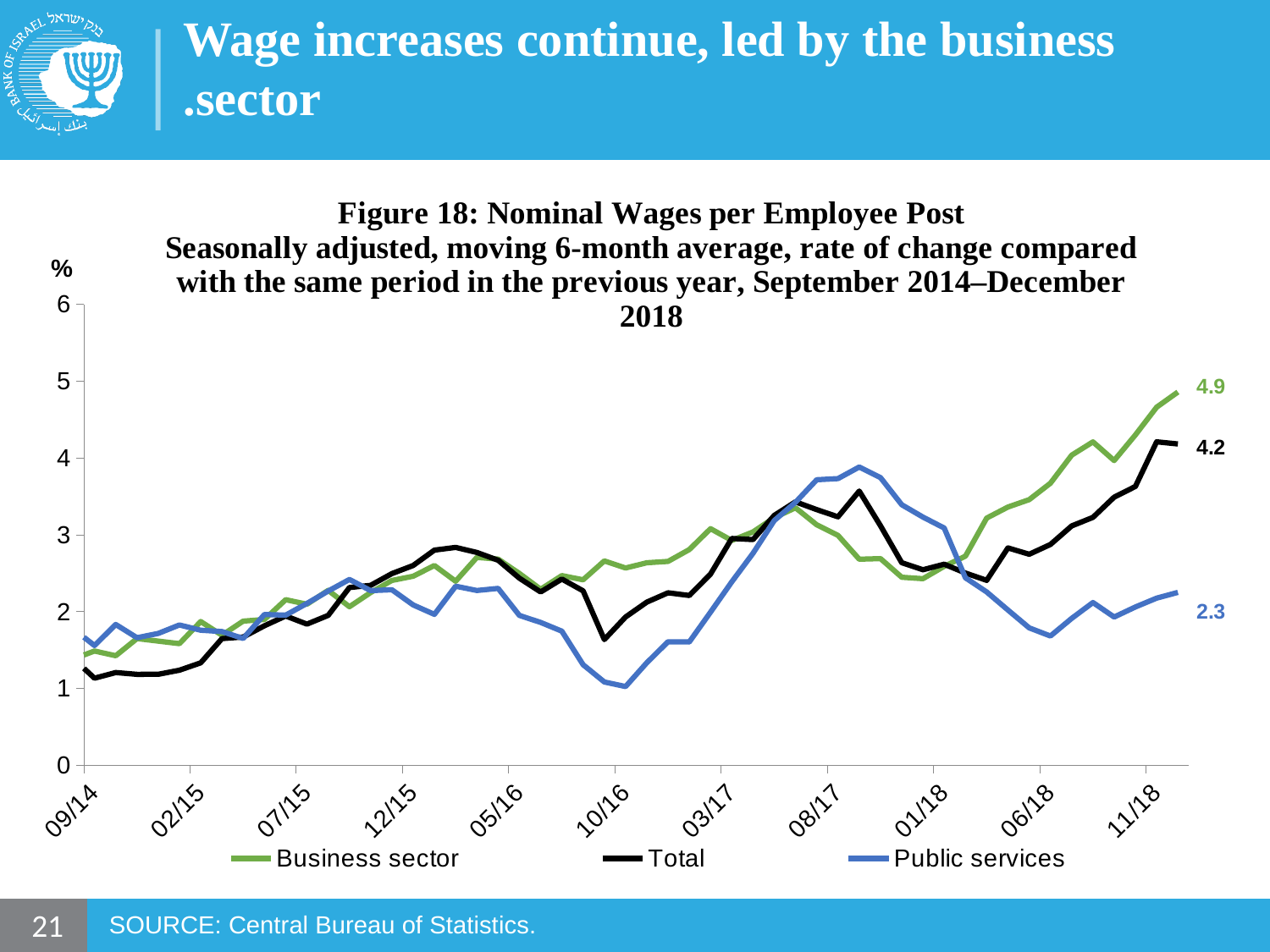
What is the difference between the final values of the Business sector and Public services series? 2.6 What is the difference between the final values of the Business sector and Total series? 0.7 What is the final value shown for the Public services series? 2.3 Does the Business sector series rise or fall between 01/18 and the end of the period? Rise At the end of the period, which is larger: the Total series or the Public services series? Total What kind of chart is shown on the slide? Line chart What is the final value shown for the Business sector series? 4.9 Which series has the lowest value at the end of the period? Public services Is the value for Public services around 10/16 greater or less than 2? less How many series does the legend list? 3 What is the final value shown for the Total series? 4.2 Which series has the highest value at the end of the period? Business sector